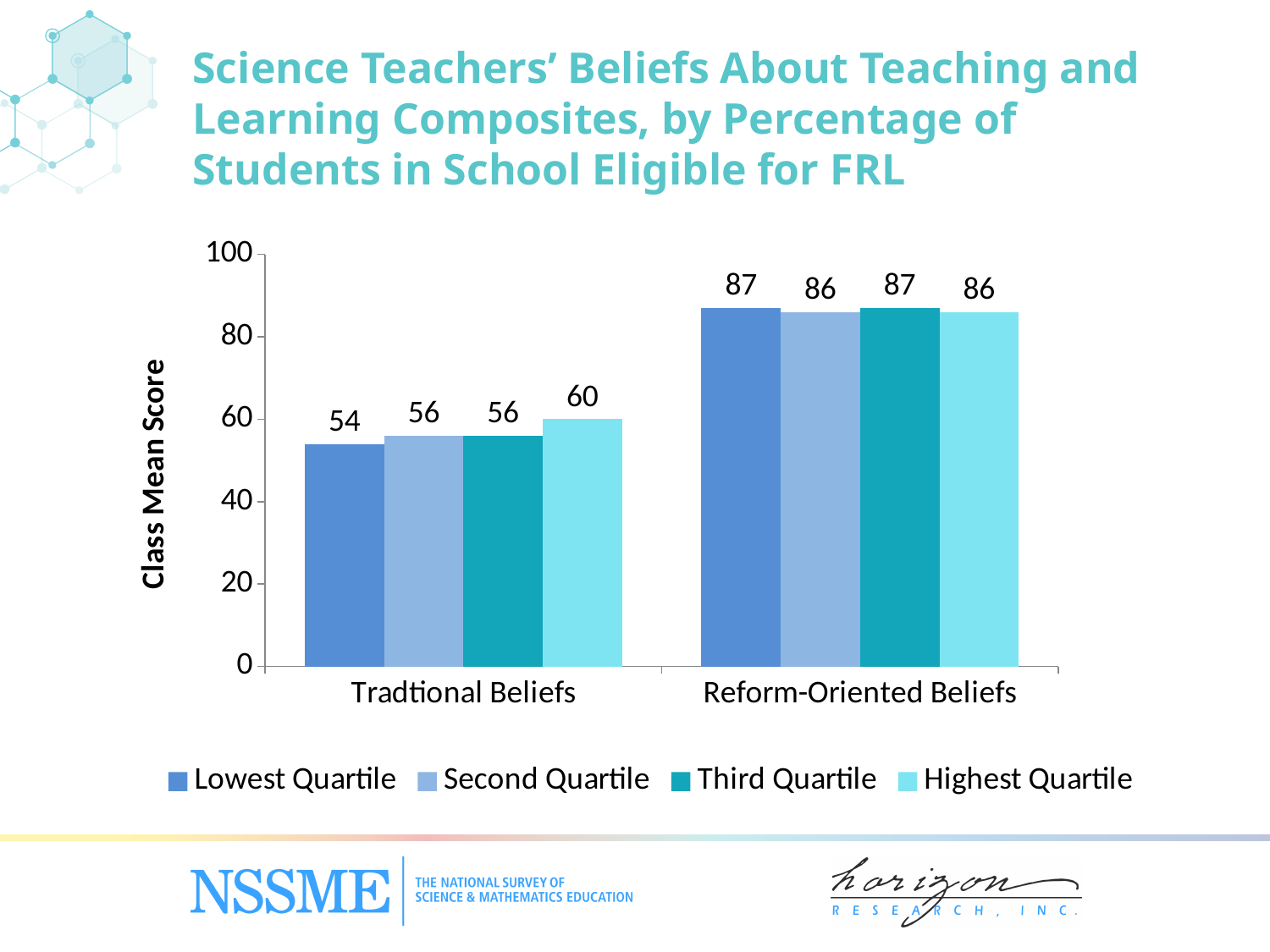
What is the class mean score for the Second Quartile on Reform-Oriented Beliefs? 86 Which quartile has the lowest class mean score for Traditional Beliefs? Lowest Quartile What is the class mean score for the Highest Quartile on Traditional Beliefs? 60 What is the class mean score for the Lowest Quartile on Traditional Beliefs? 54 Which is larger for the Highest Quartile: the Traditional Beliefs score or the Reform-Oriented Beliefs score? Reform-Oriented Beliefs What is the label of the vertical axis? Class Mean Score What is the class mean score for the Third Quartile on Reform-Oriented Beliefs? 87 What is the difference between the Highest Quartile and Lowest Quartile scores for Traditional Beliefs? 6 What is the difference between the Lowest Quartile's Reform-Oriented Beliefs score and its Traditional Beliefs score? 33 What type of chart is shown on the slide? Bar chart Which quartile has the highest class mean score for Traditional Beliefs? Highest Quartile How many series does the legend list? 4